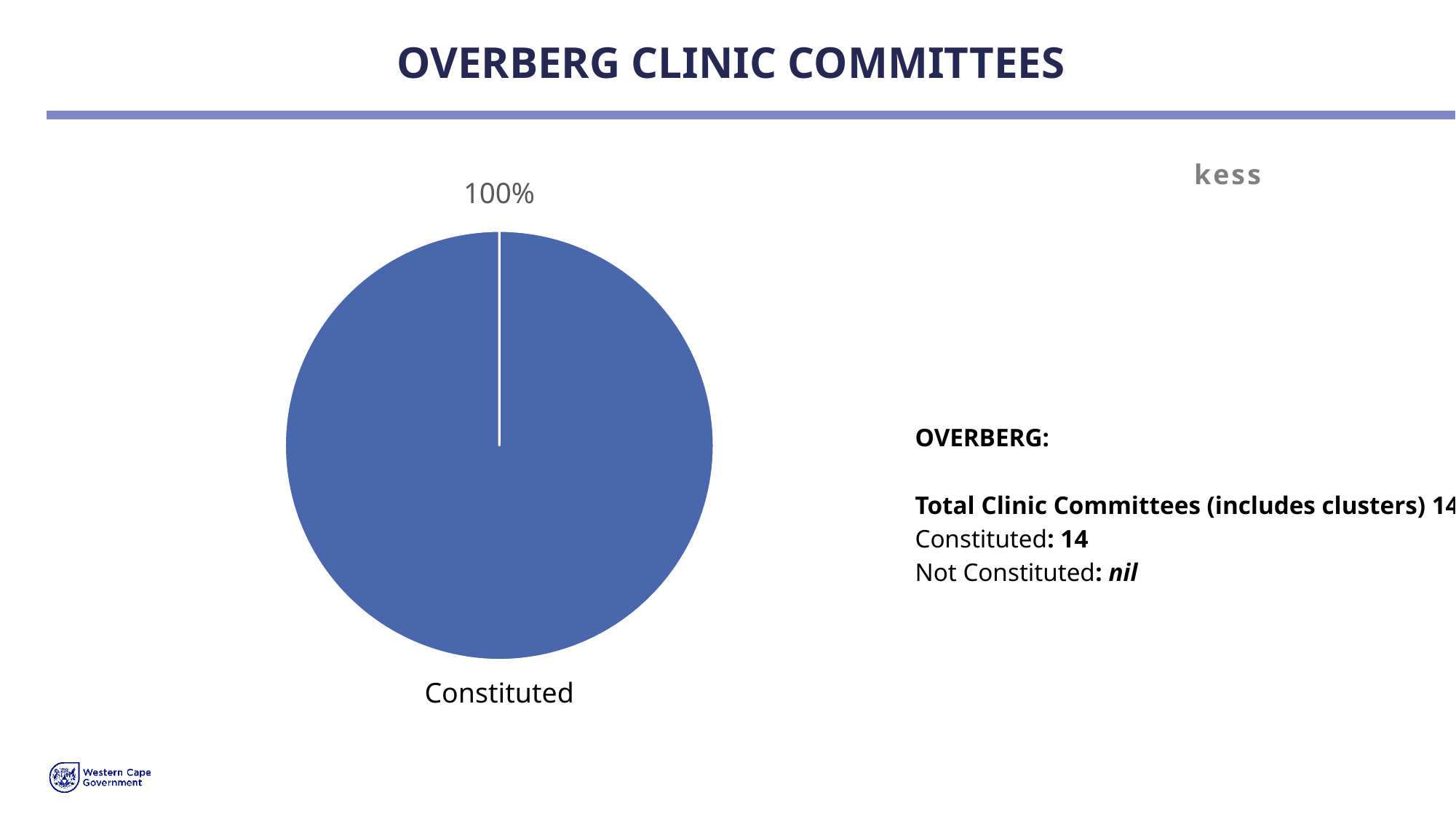
How many slices does the pie chart have? 1 What colour is the Constituted slice of the pie chart? blue What is the label of the only slice in the pie chart? Constituted What is the title of the slide containing the pie chart? OVERBERG CLINIC COMMITTEES What is the data label shown above the pie chart? 100% What share of the pie does the Constituted slice represent? 100% What kind of chart is shown on the slide? pie chart